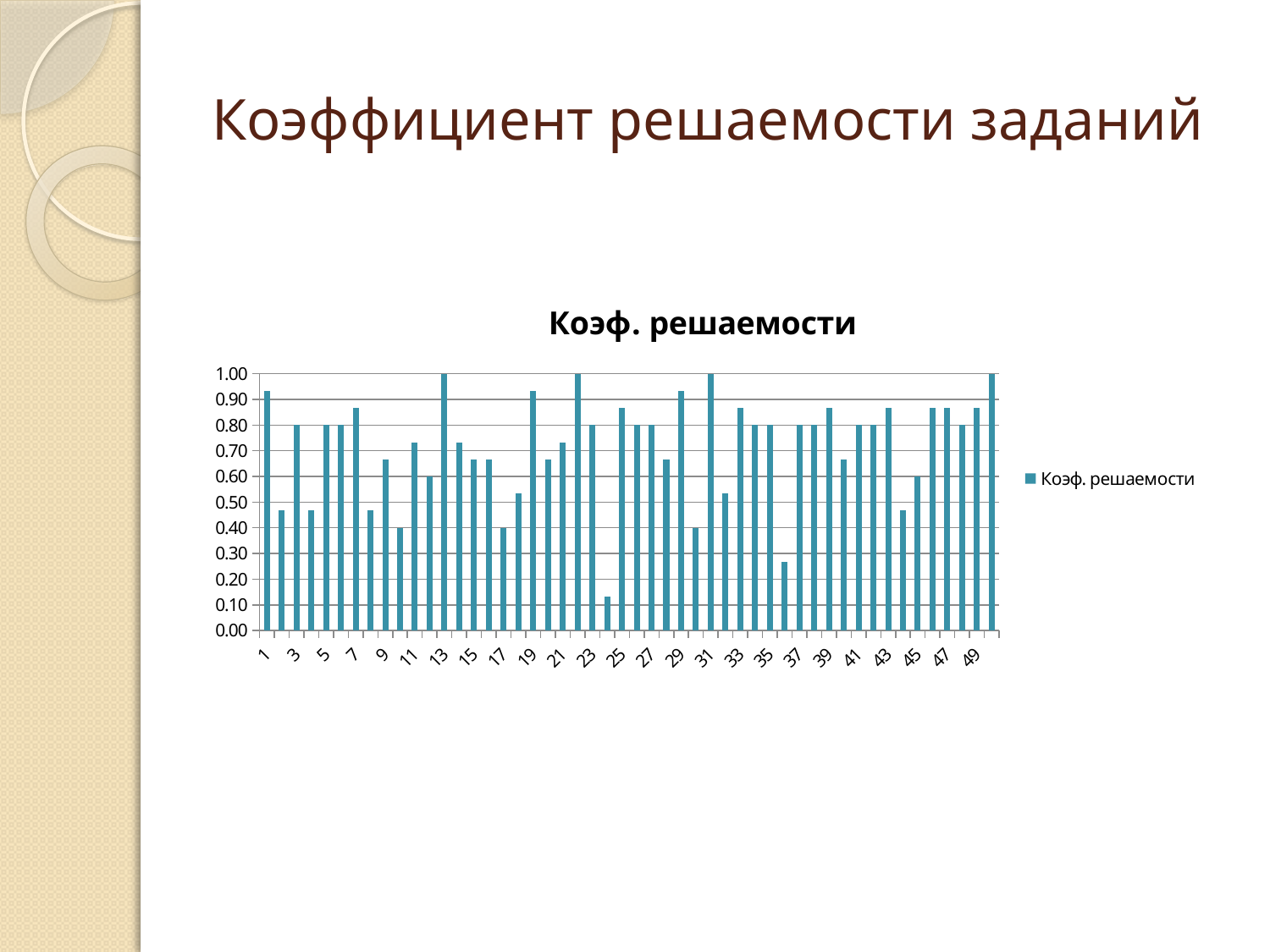
How many categories (bars) are plotted in the chart? 50 What kind of chart is shown on the slide? bar chart Is the value for category 24 greater or less than 0.20? less Which category has the lowest value in the chart? 24 What is the value for category 31? 1.00 Is the value for category 36 greater or less than 0.30? less What is the value for category 13? 1.00 Which is larger, the value for category 13 or the value for category 24? 13 What is the title of the chart? Коэф. решаемости Is the value for category 1 greater or less than 0.90? greater What is the legend entry of the chart? Коэф. решаемости How many series does the legend list? 1